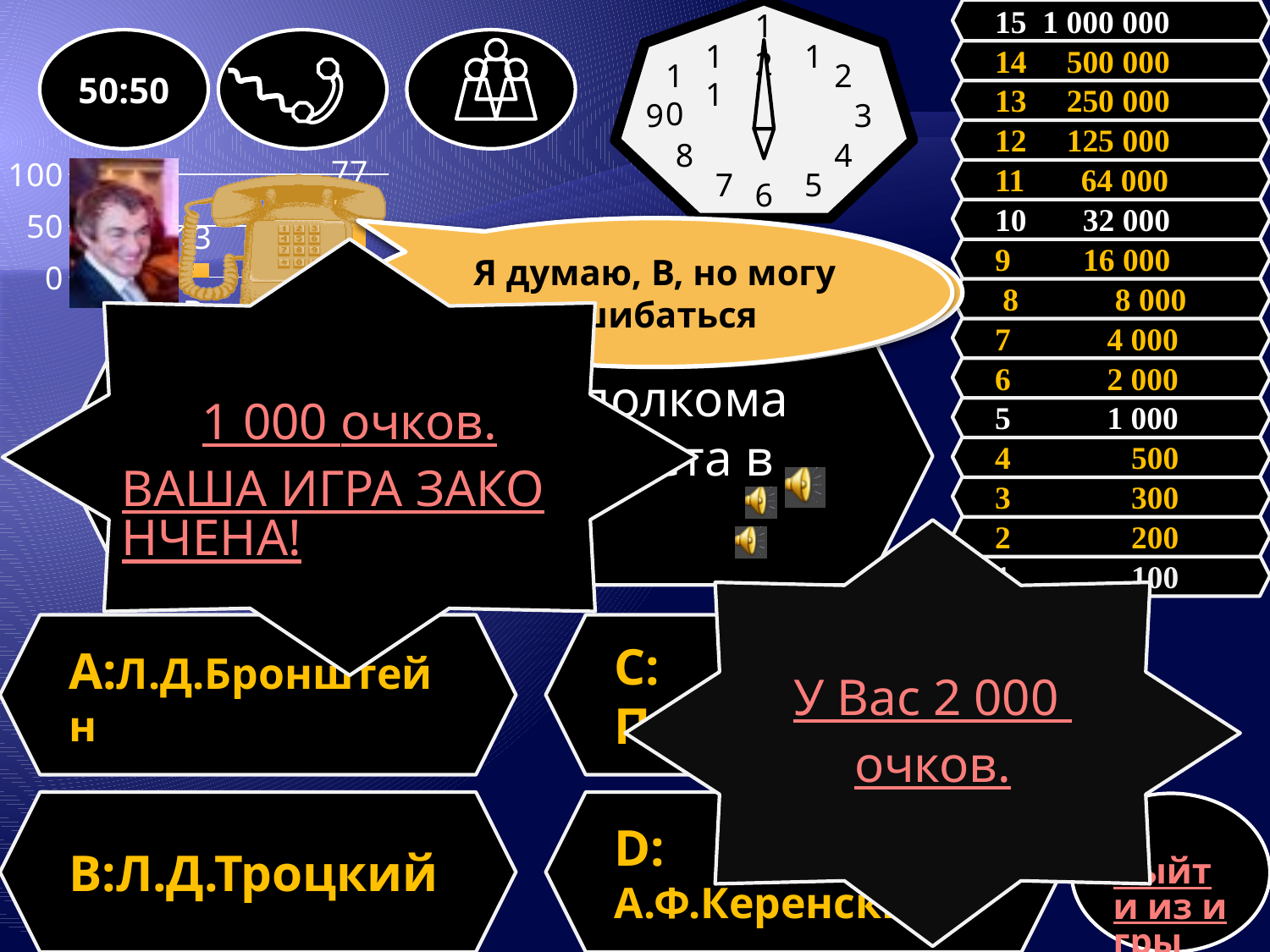
What is the highest tick value shown on the vertical axis of the small chart in the top-left of the slide? 100 What is the lowest tick value shown on the vertical axis of the small chart in the top-left of the slide? 0 What is the largest data label visible on the small chart in the top-left of the slide? 77